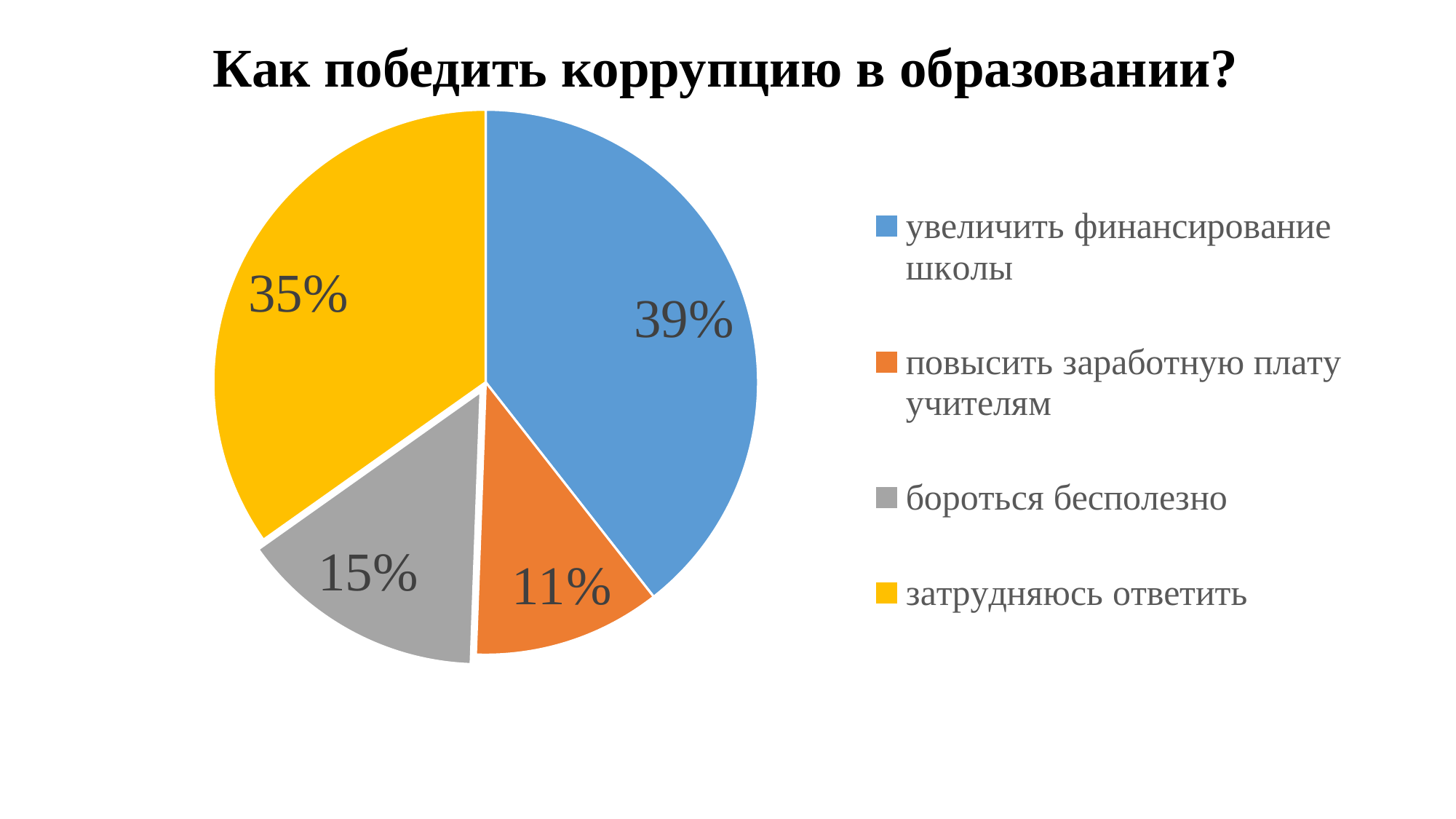
What share of the pie does "бороться бесполезно" have? 15% What is the title of the chart? Как победить коррупцию в образовании? Which category has the smallest slice of the pie? повысить заработную плату учителям What share of the pie does "увеличить финансирование школы" have? 39% What share of the pie does "затрудняюсь ответить" have? 35% Which category has the largest slice of the pie? увеличить финансирование школы Which is larger: the share for "бороться бесполезно" or the share for "повысить заработную плату учителям"? бороться бесполезно What type of chart is shown on the slide? pie chart What is the difference between the shares for "увеличить финансирование школы" and "затрудняюсь ответить"? 4% What colour is the slice for "затрудняюсь ответить"? yellow How many categories does the pie chart have? 4